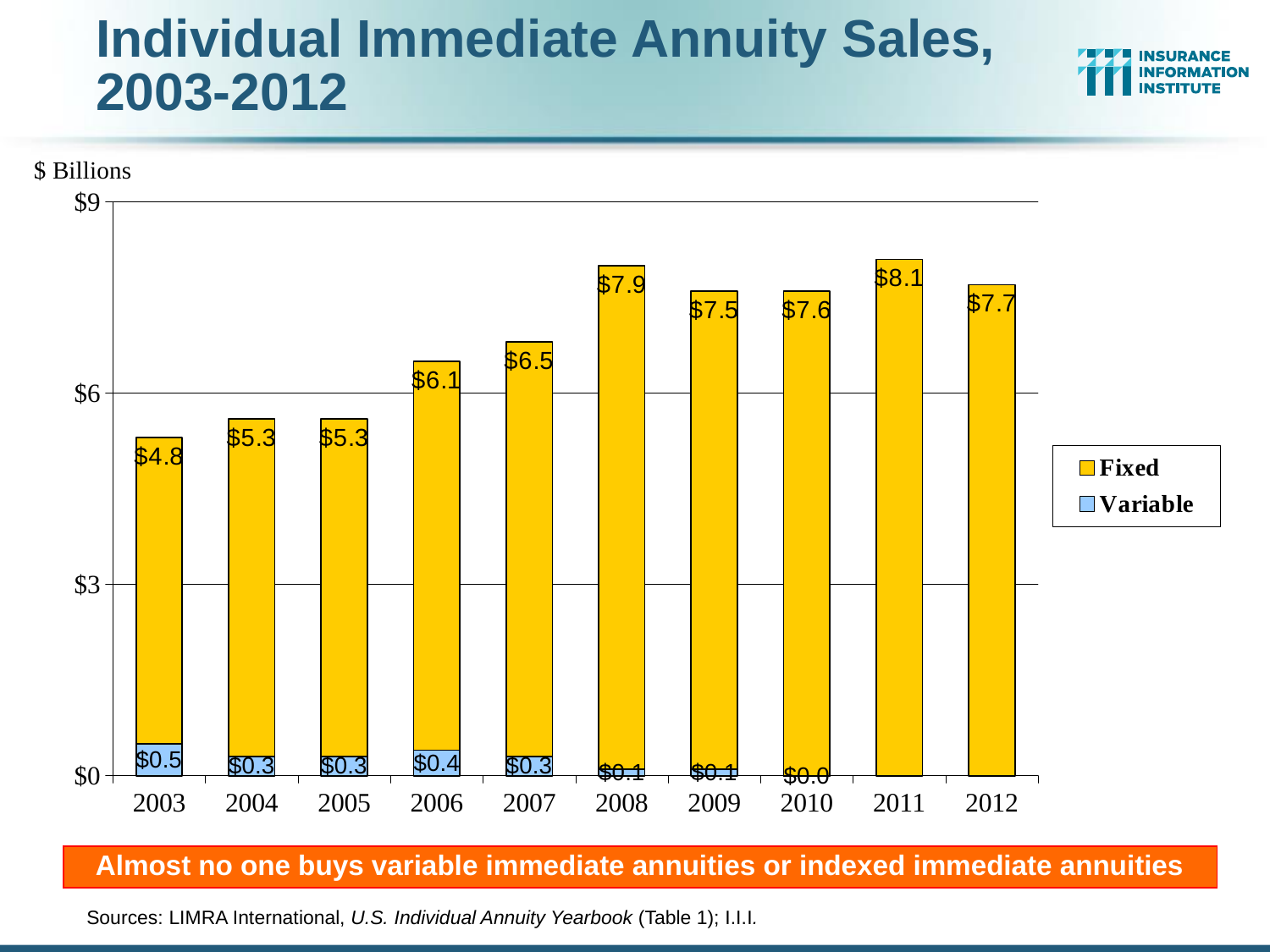
How many years are shown on the x axis? 10 Which is larger, the Fixed value for 2008 or the Fixed value for 2009? 2008 What is the Fixed value for 2006? $6.1 Is the total bar for 2003 greater or less than $3? greater What is the total of the stacked bar for 2003 (Fixed plus Variable)? $5.3 Which year has the highest Fixed value? 2011 How many series does the legend list? 2 What is the Fixed value for 2011? $8.1 What kind of chart is this? Stacked bar chart Which year has the lowest Fixed value? 2003 What is the Variable value for 2003? $0.5 What is the difference between the Fixed values for 2011 and 2003? $3.3